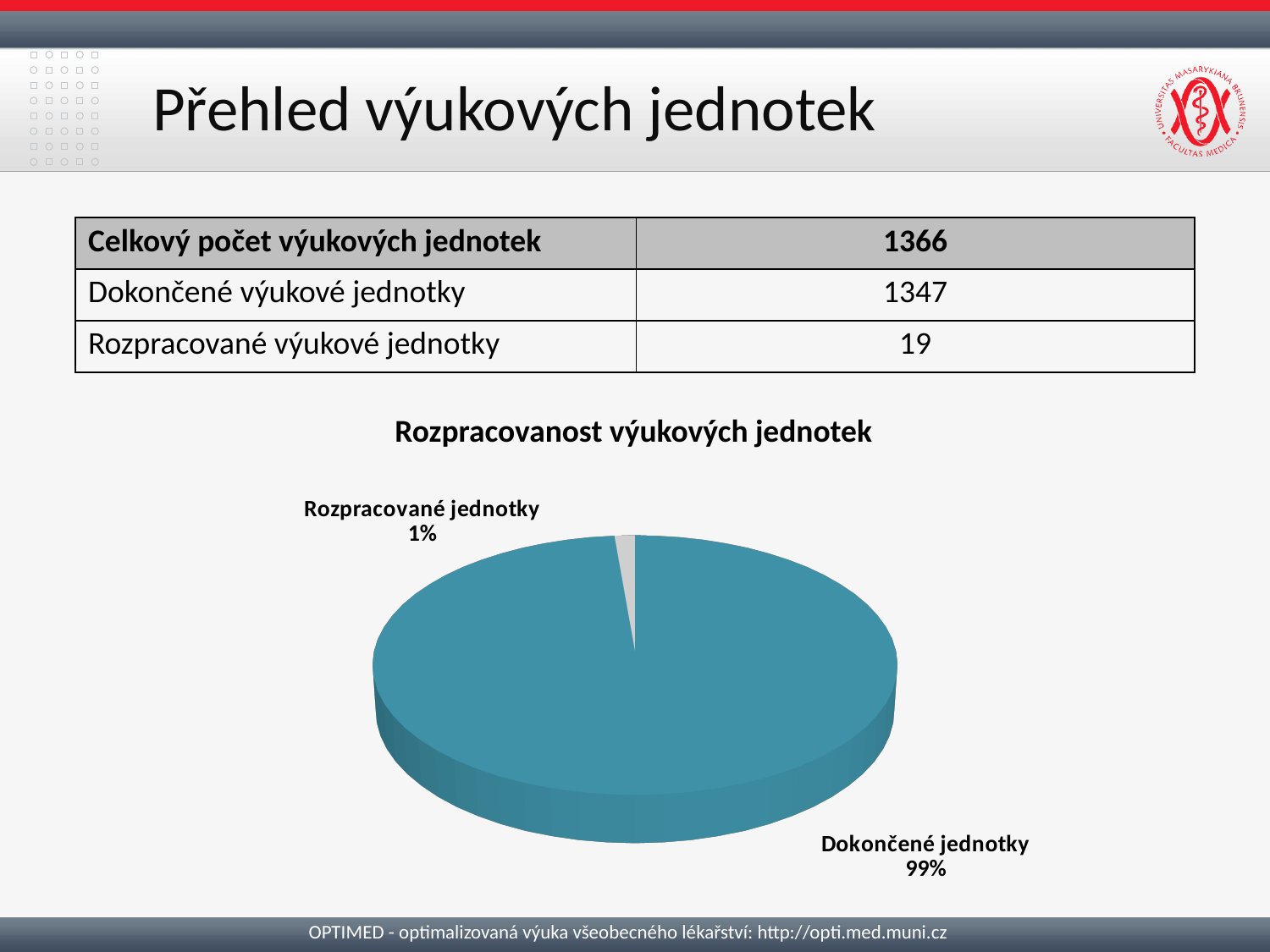
What kind of chart is shown on the slide? pie chart What is the difference in percentage points between the Dokončené jednotky slice and the Rozpracované jednotky slice? 98 percentage points What share of the pie is labelled for Dokončené jednotky? 99% What is the title of the chart? Rozpracovanost výukových jednotek What colour is the slice for Dokončené jednotky? teal blue Which is larger, the slice for Dokončené jednotky or the slice for Rozpracované jednotky? Dokončené jednotky Which slice of the pie is the smallest? Rozpracované jednotky What share of the pie is labelled for Rozpracované jednotky? 1% Which slice of the pie is the largest? Dokončené jednotky How many slices does the pie chart have? 2